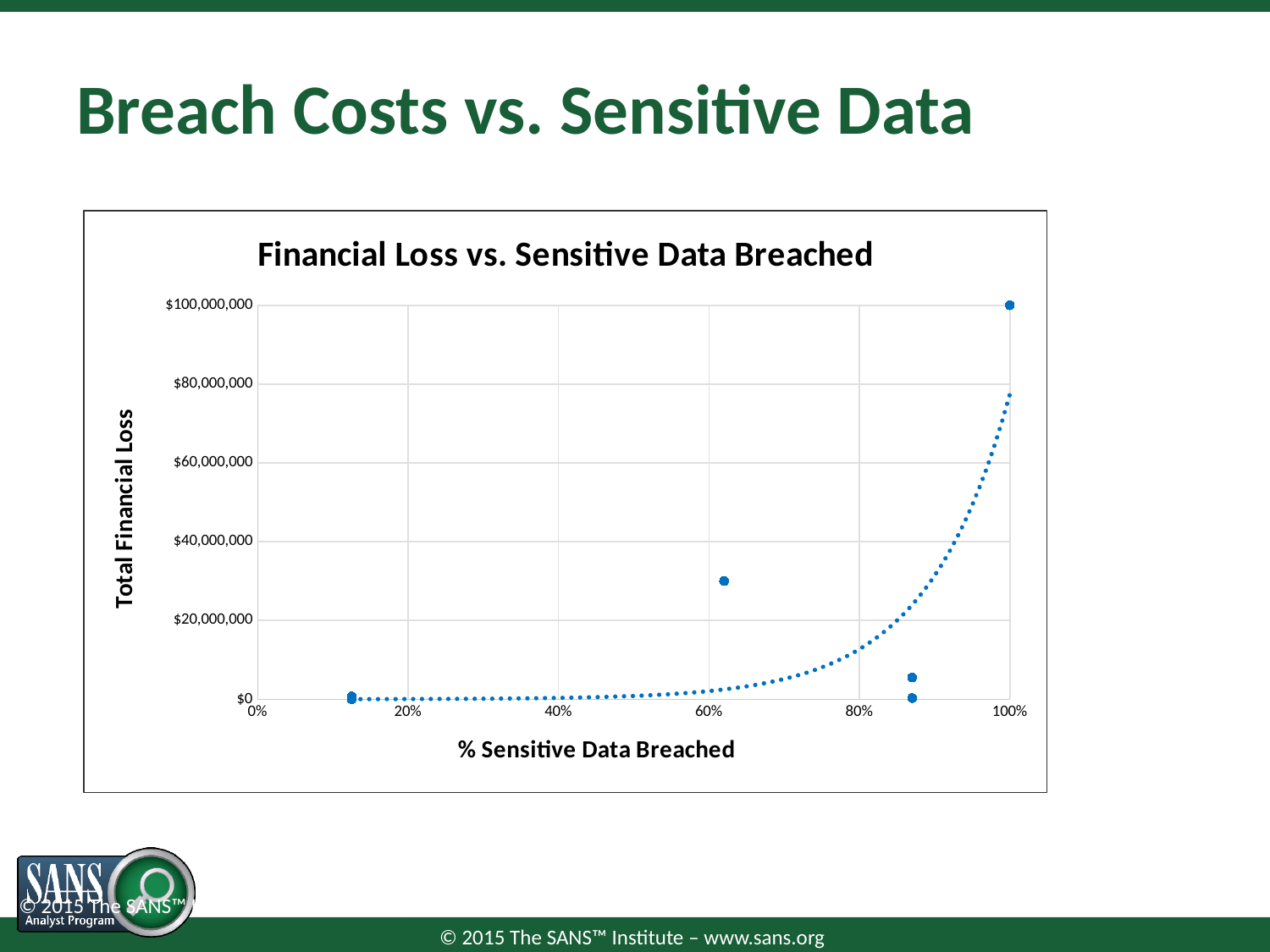
Is the total financial loss for the highest point near 87% sensitive data breached greater or less than $20,000,000? less What is the title of the chart? Financial Loss vs. Sensitive Data Breached What kind of chart is shown on the slide? scatter chart At what percentage of sensitive data breached does the point with the highest total financial loss occur? 100% Does the dotted trendline rise or fall as the percentage of sensitive data breached increases? rises Is the total financial loss for the points near 12% sensitive data breached greater or less than $20,000,000? less What is the total financial loss for the point at 100% sensitive data breached? $100,000,000 Is the total financial loss for the point at about 62% sensitive data breached greater or less than $20,000,000? greater What is the label of the vertical axis? Total Financial Loss Which has a higher total financial loss: the point at about 62% sensitive data breached or the points near 87%? the point at about 62%